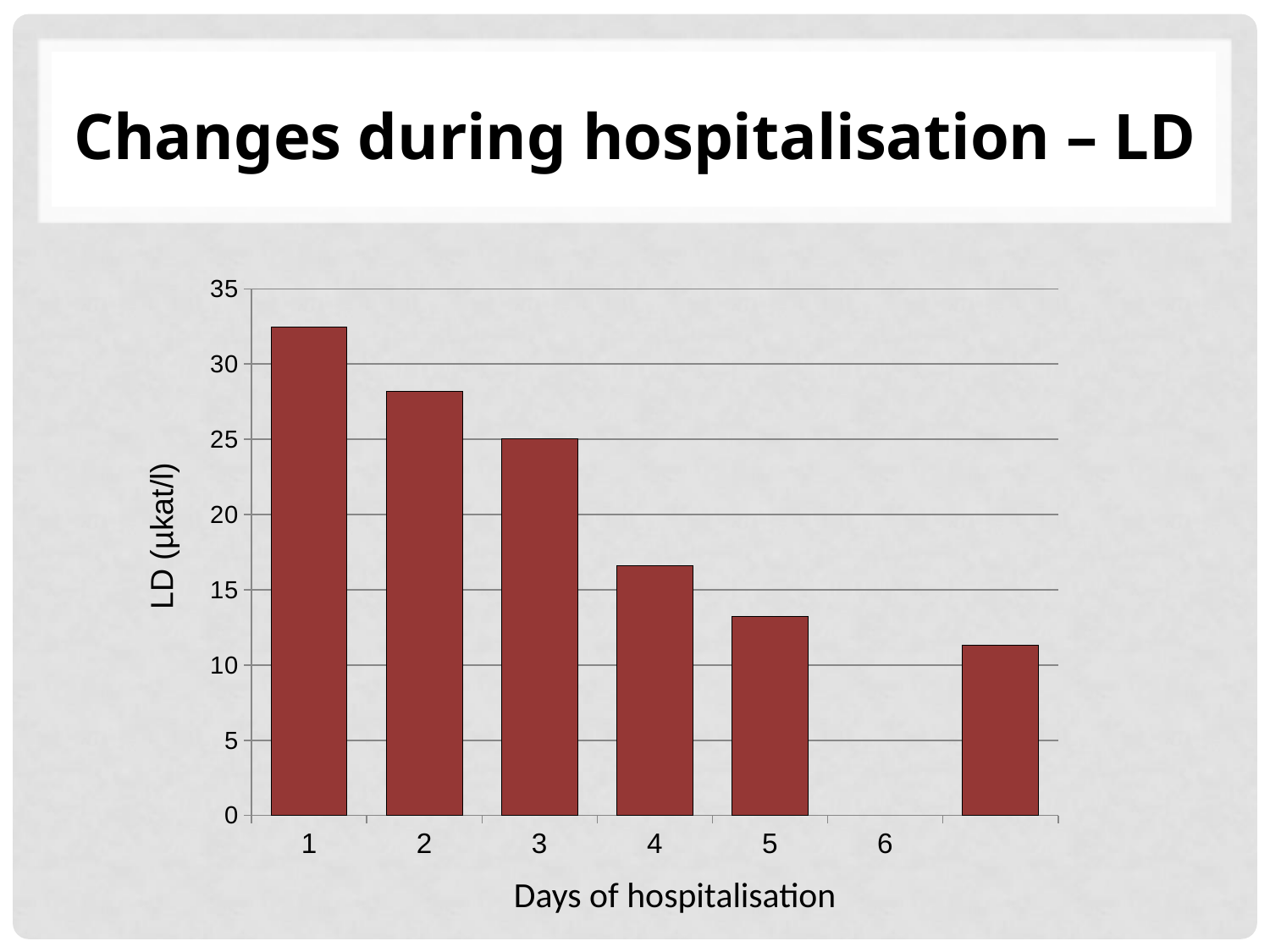
Is the LD value for day 1 greater or less than 30? greater What is the label of the y axis? LD (µkat/l) Among days 1 to 5, which day has the lowest LD value? 5 Which day of hospitalisation has the highest LD value? 1 What kind of chart is shown on the slide? bar chart Which has a higher LD value, day 2 or day 4? day 2 Do the LD values rise or fall across the days of hospitalisation? fall How many day labels are shown on the x axis? 6 Is the LD value for day 5 greater or less than 15? less Is the LD value for day 4 greater or less than 20? less What is the label of the x axis? Days of hospitalisation